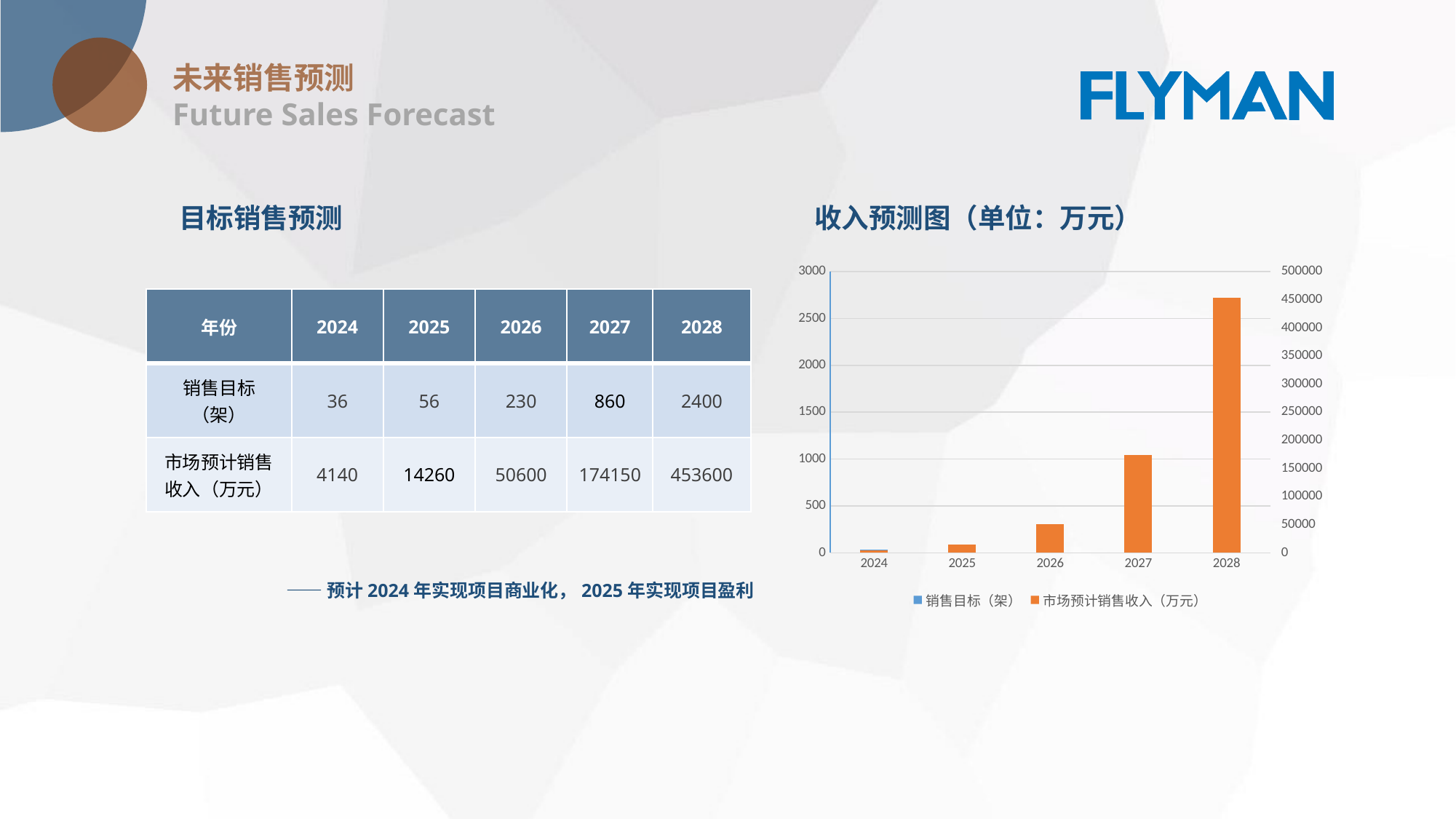
What is the 市场预计销售收入（万元） value for 2028 shown on the slide? 453600 In the 收入预测图 chart, which year has the highest 市场预计销售收入 bar? 2028 In the 收入预测图 chart, is the 市场预计销售收入 value for 2028 greater or less than 400000? greater What kind of chart is shown under the title 收入预测图（单位：万元）? bar chart How many years are shown on the x axis of the 收入预测图 chart? 5 In the 收入预测图 chart, do the 市场预计销售收入 bars rise or fall from 2024 to 2028? rise What colour are the 市场预计销售收入（万元） bars in the 收入预测图 chart? orange In the 收入预测图 chart, is the 市场预计销售收入 value for 2027 greater or less than 150000? greater In the 收入预测图 chart, is the 市场预计销售收入 value for 2026 greater or less than 100000? less How many series does the legend of the 收入预测图 chart list? 2 In the 收入预测图 chart, which year has the lowest 市场预计销售收入 bar? 2024 In the 收入预测图 chart, which year has the larger 市场预计销售收入 bar, 2026 or 2027? 2027